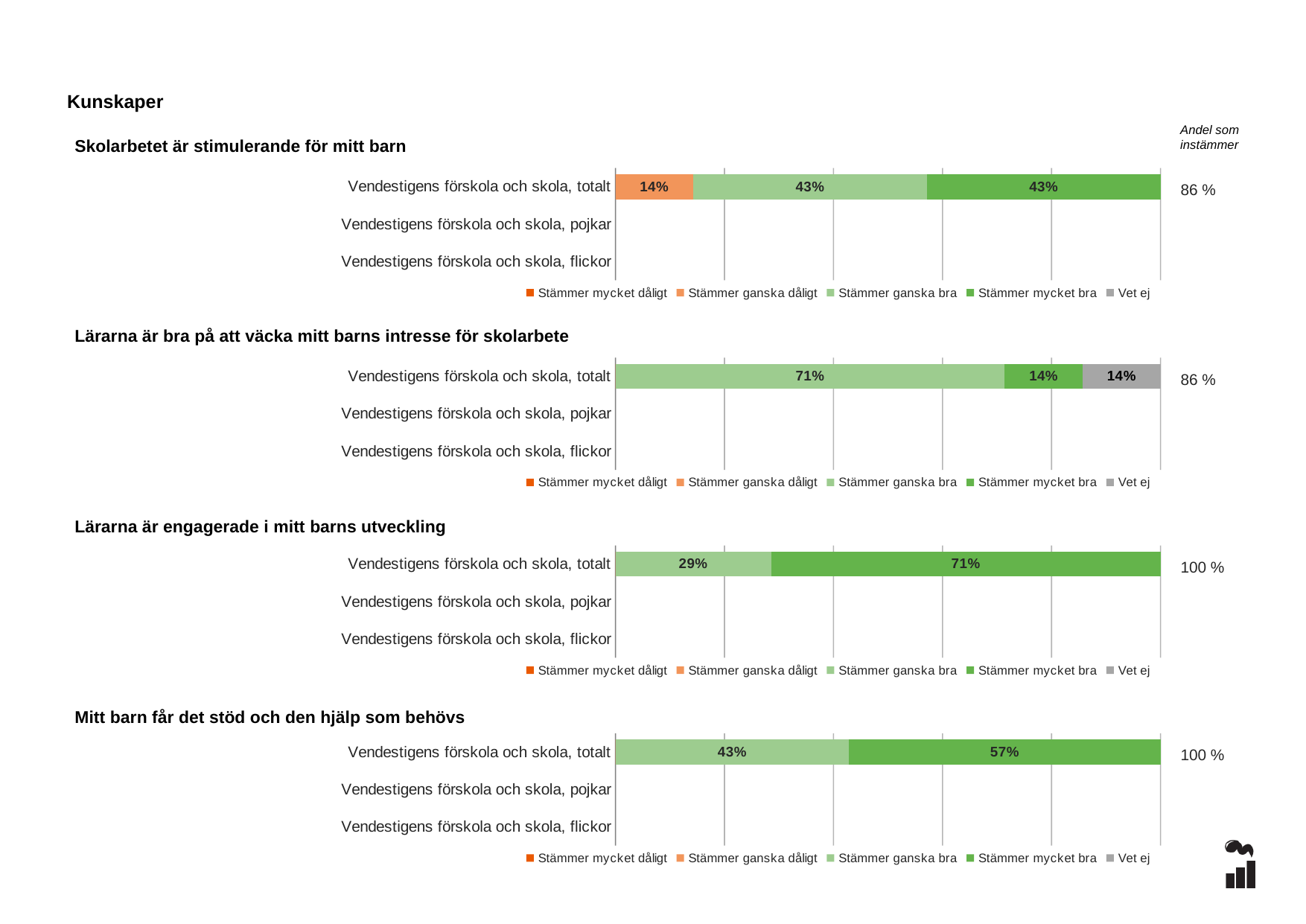
How many series does the legend of the chart 'Mitt barn får det stöd och den hjälp som behövs' list? 5 In the chart 'Lärarna är bra på att väcka mitt barns intresse för skolarbete', what is the value of the 'Vet ej' segment for the totalt row? 14% In the chart 'Lärarna är engagerade i mitt barns utveckling', which segment is larger for the totalt row: 'Stämmer ganska bra' or 'Stämmer mycket bra'? Stämmer mycket bra In the chart 'Mitt barn får det stöd och den hjälp som behövs', what is the total of the labelled segments in the totalt bar? 100% In the chart 'Mitt barn får det stöd och den hjälp som behövs', what is the value of the 'Stämmer mycket bra' segment for the totalt row? 57% In the chart 'Skolarbetet är stimulerande för mitt barn', what is the value of the 'Stämmer ganska dåligt' segment for 'Vendestigens förskola och skola, totalt'? 14% What is the 'Andel som instämmer' value shown for the chart 'Skolarbetet är stimulerande för mitt barn'? 86 % In the chart 'Lärarna är bra på att väcka mitt barns intresse för skolarbete', what is the value of the 'Stämmer ganska bra' segment for the totalt row? 71% In the chart 'Skolarbetet är stimulerande för mitt barn', what is the value of the 'Stämmer mycket bra' segment for 'Vendestigens förskola och skola, totalt'? 43% What kind of chart is 'Lärarna är bra på att väcka mitt barns intresse för skolarbete'? Stacked bar chart What is the 'Andel som instämmer' value shown for the chart 'Lärarna är engagerade i mitt barns utveckling'? 100 % In the chart 'Lärarna är engagerade i mitt barns utveckling', what is the difference between the 'Stämmer mycket bra' and 'Stämmer ganska bra' segments for the totalt row? 42%